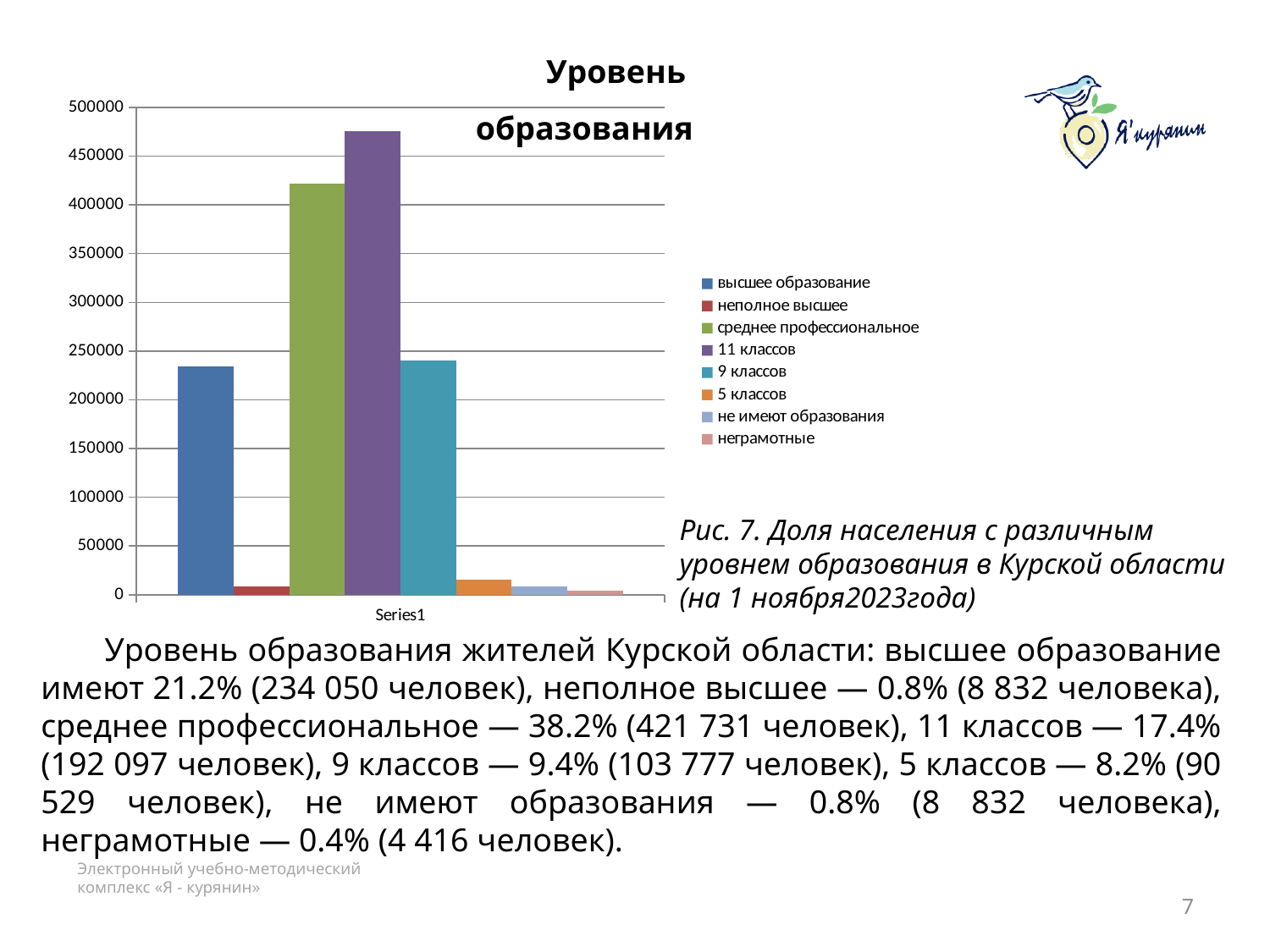
What kind of chart is shown on the slide? bar chart Is the value for 5 классов greater or less than 50000? less What is the title of the chart? Уровень образования Which is larger, the bar for 9 классов or the bar for 5 классов? 9 классов Which category has the tallest bar in the chart? 11 классов How many entries does the chart legend list? 8 Which category has the shortest bar in the chart? неграмотные Is the value for 11 классов greater or less than 450000? greater How many bars are plotted in the chart? 8 Is the value for среднее профессиональное greater or less than 400000? greater Which is larger, the bar for среднее профессиональное or the bar for высшее образование? среднее профессиональное